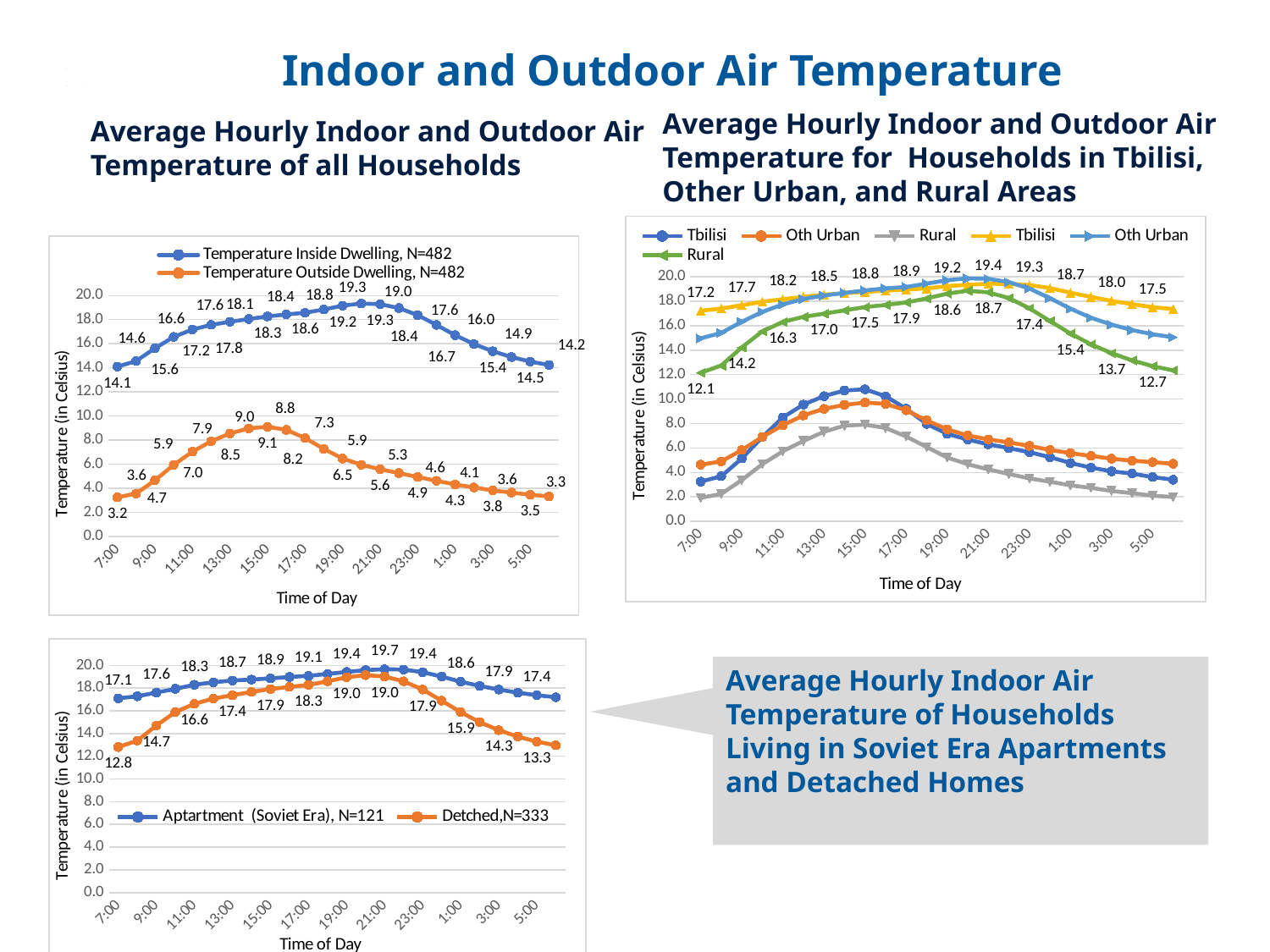
In the chart titled 'Average Hourly Indoor and Outdoor Air Temperature of all Households', what is the highest value labeled on the Temperature Outside Dwelling line? 9.1 In the bottom-left chart of Soviet Era Apartments and Detached Homes, which series has the higher value at 5:00? Aptartment (Soviet Era), N=121 In the chart titled 'Average Hourly Indoor and Outdoor Air Temperature of all Households', does the outside temperature rise or fall from 7:00 to 15:00? Rise In the chart titled 'Average Hourly Indoor and Outdoor Air Temperature of all Households', what is the lowest value labeled on the Temperature Outside Dwelling line? 3.2 How many series does the legend list in the chart for Households in Tbilisi, Other Urban, and Rural Areas? 6 In the chart for Households in Tbilisi, Other Urban, and Rural Areas, what is the labeled value of the Tbilisi indoor line at 7:00? 17.2 In the bottom-left chart of Soviet Era Apartments and Detached Homes, what is the value for Detched, N=333 at 7:00? 12.8 What kind of chart is the 'Average Hourly Indoor and Outdoor Air Temperature of all Households' chart? Line chart In the chart titled 'Average Hourly Indoor and Outdoor Air Temperature of all Households', what is the difference between the inside and outside temperature at 7:00? 10.9 In the bottom-left chart of Soviet Era Apartments and Detached Homes, what is the highest labeled value for Aptartment (Soviet Era), N=121? 19.7 In the chart titled 'Average Hourly Indoor and Outdoor Air Temperature of all Households', what is the Temperature Inside Dwelling at 7:00? 14.1 In the chart for Households in Tbilisi, Other Urban, and Rural Areas, what is the highest labeled value on the Rural indoor line? 18.7